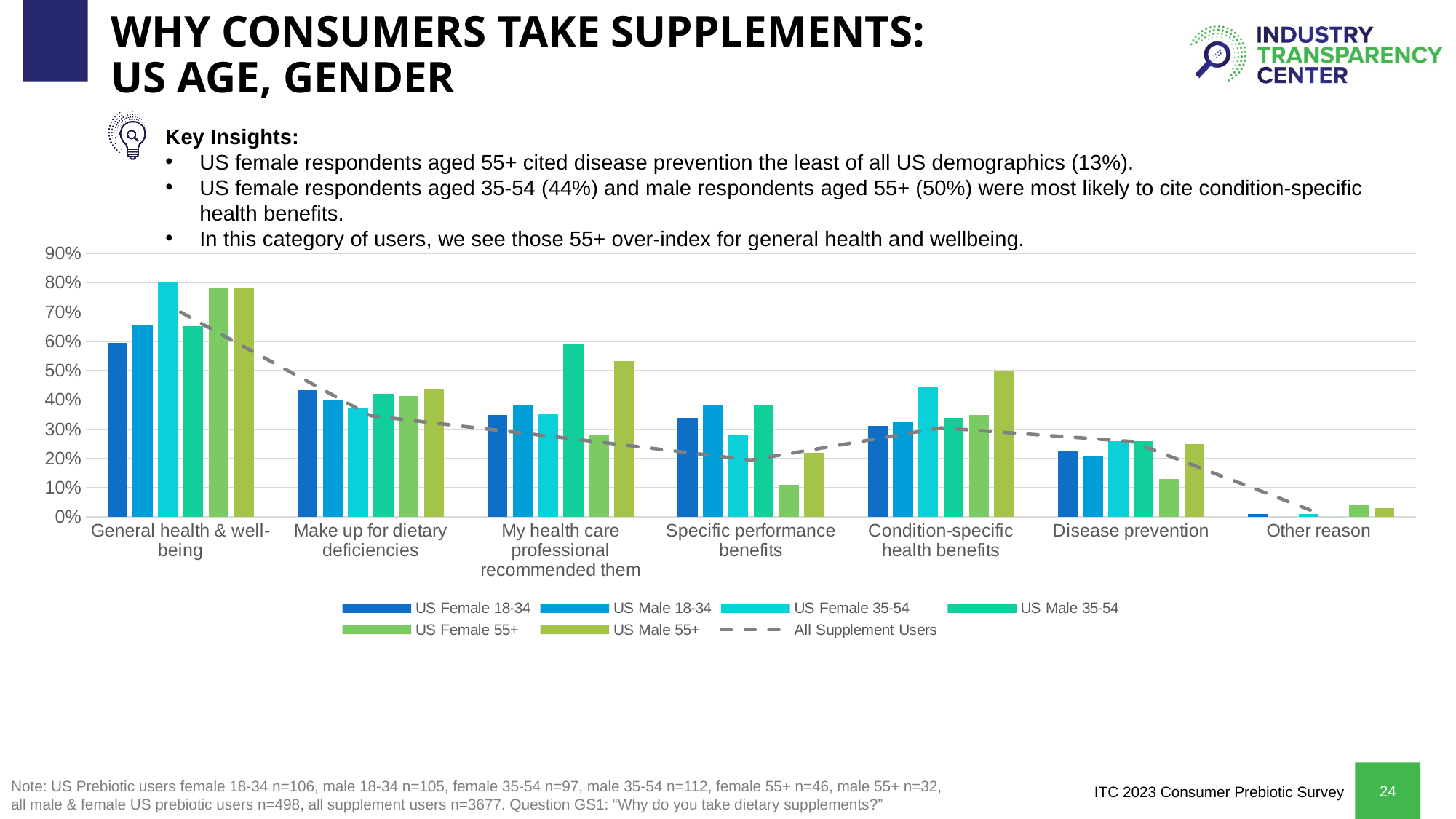
Within Disease prevention, which series has the lowest bar? US Female 55+ Does the dashed All Supplement Users line generally rise or fall from left to right across the categories? Fall What kind of chart is shown on the slide? Bar chart (with a dashed line series) In General health & well-being, which is larger: US Female 18-34 or US Male 18-34? US Male 18-34 Which category has the highest bars overall? General health & well-being How many series does the legend list? 7 Is the value for US Male 35-54 in My health care professional recommended them greater or less than 50%? greater Is the value for US Female 55+ in Specific performance benefits greater or less than 20%? less How many reason categories are shown along the x axis? 7 Which series is drawn as a dashed line rather than bars? All Supplement Users Is the value for US Female 35-54 in General health & well-being greater or less than 70%? greater Which category has the lowest bars overall? Other reason